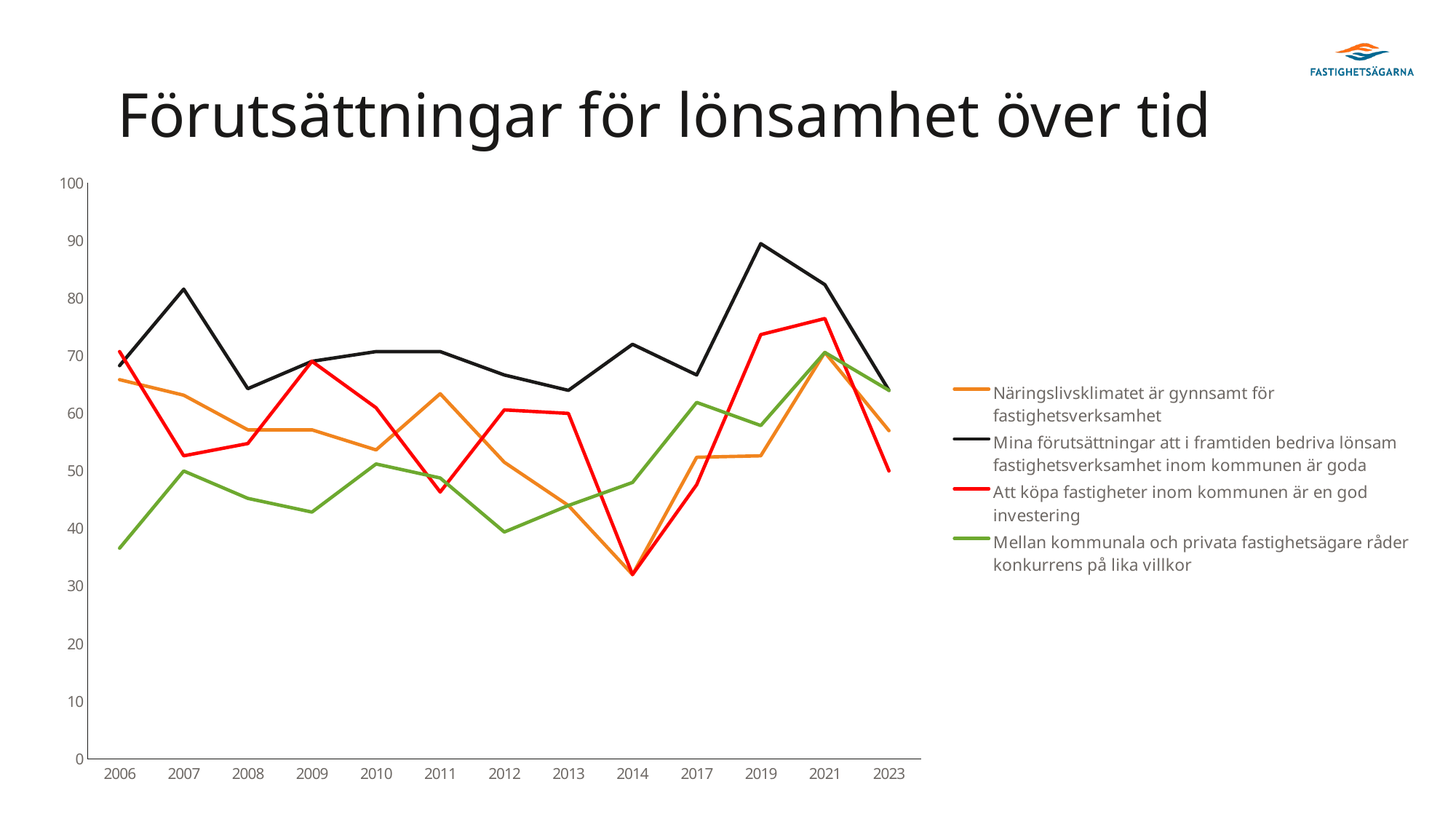
Does the series "Mina förutsättningar att i framtiden bedriva lönsam fastighetsverksamhet inom kommunen är goda" rise or fall from 2021 to 2023? fall What kind of chart is shown on the slide? line chart Is the 2019 value for "Mina förutsättningar att i framtiden bedriva lönsam fastighetsverksamhet inom kommunen är goda" greater or less than 80? greater How many years are shown along the x axis? 13 How many series does the legend list? 4 What colour is the line for "Att köpa fastigheter inom kommunen är en god investering"? red In which year does the series "Mellan kommunala och privata fastighetsägare råder konkurrens på lika villkor" reach its highest value? 2021 Is the 2023 value for "Att köpa fastigheter inom kommunen är en god investering" greater or less than 60? less In which year is the series "Näringslivsklimatet är gynnsamt för fastighetsverksamhet" at its lowest? 2014 In which year does the series "Mina förutsättningar att i framtiden bedriva lönsam fastighetsverksamhet inom kommunen är goda" reach its highest value? 2019 Is the 2006 value for "Mellan kommunala och privata fastighetsägare råder konkurrens på lika villkor" greater or less than 40? less In 2014, which series has the higher value: "Mellan kommunala och privata fastighetsägare råder konkurrens på lika villkor" or "Att köpa fastigheter inom kommunen är en god investering"? Mellan kommunala och privata fastighetsägare råder konkurrens på lika villkor